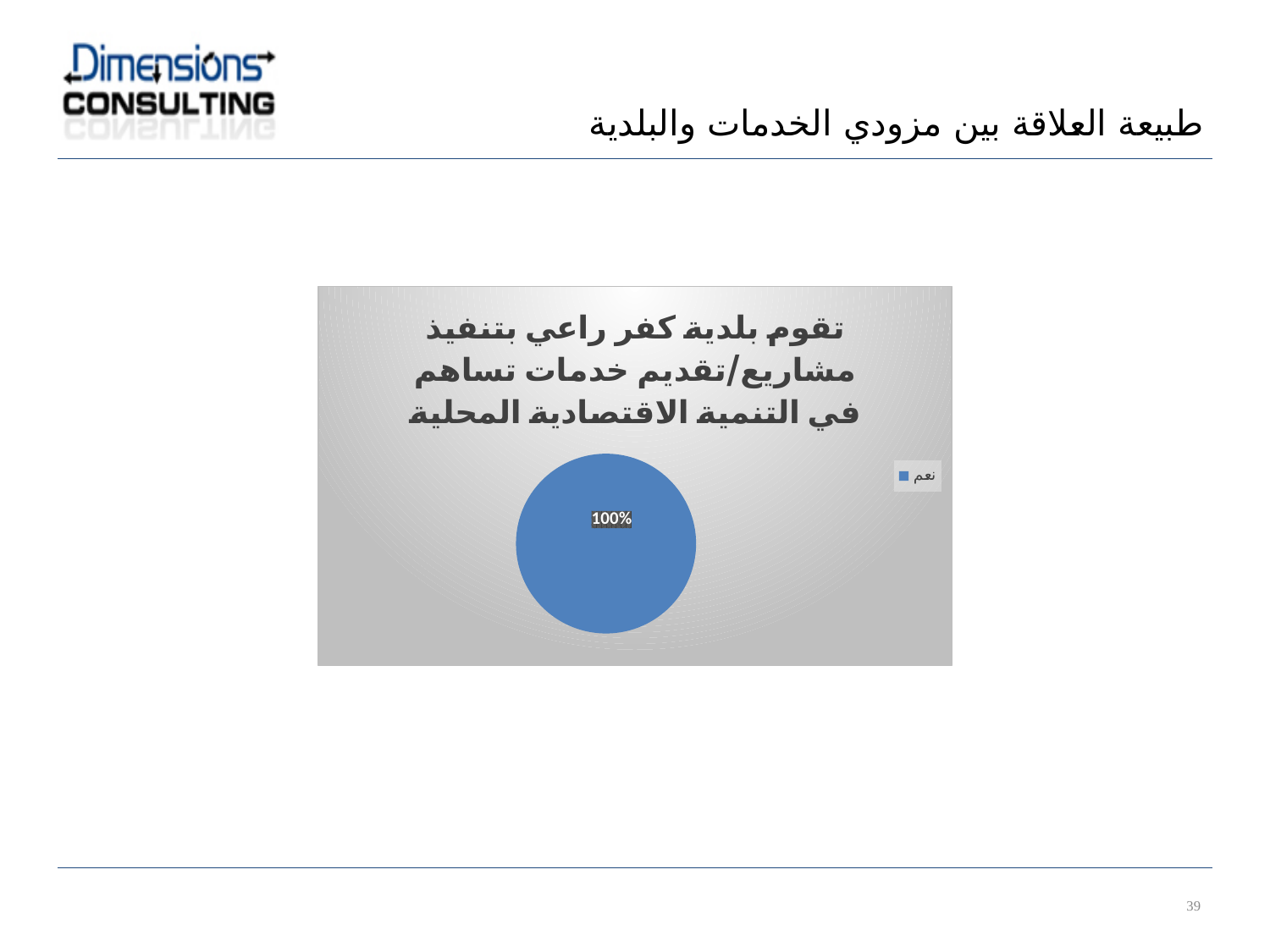
What is the only category listed in the legend of the pie chart? نعم Is the value shown on the pie chart greater or less than 50%? greater What kind of chart is shown on the slide? pie chart How many entries does the legend of the pie chart list? 1 What percentage is shown for the "نعم" slice of the pie chart? 100% What share of the pie does the "نعم" slice represent? 100% How many slices does the pie chart have? 1 What colour is the slice of the pie chart? blue